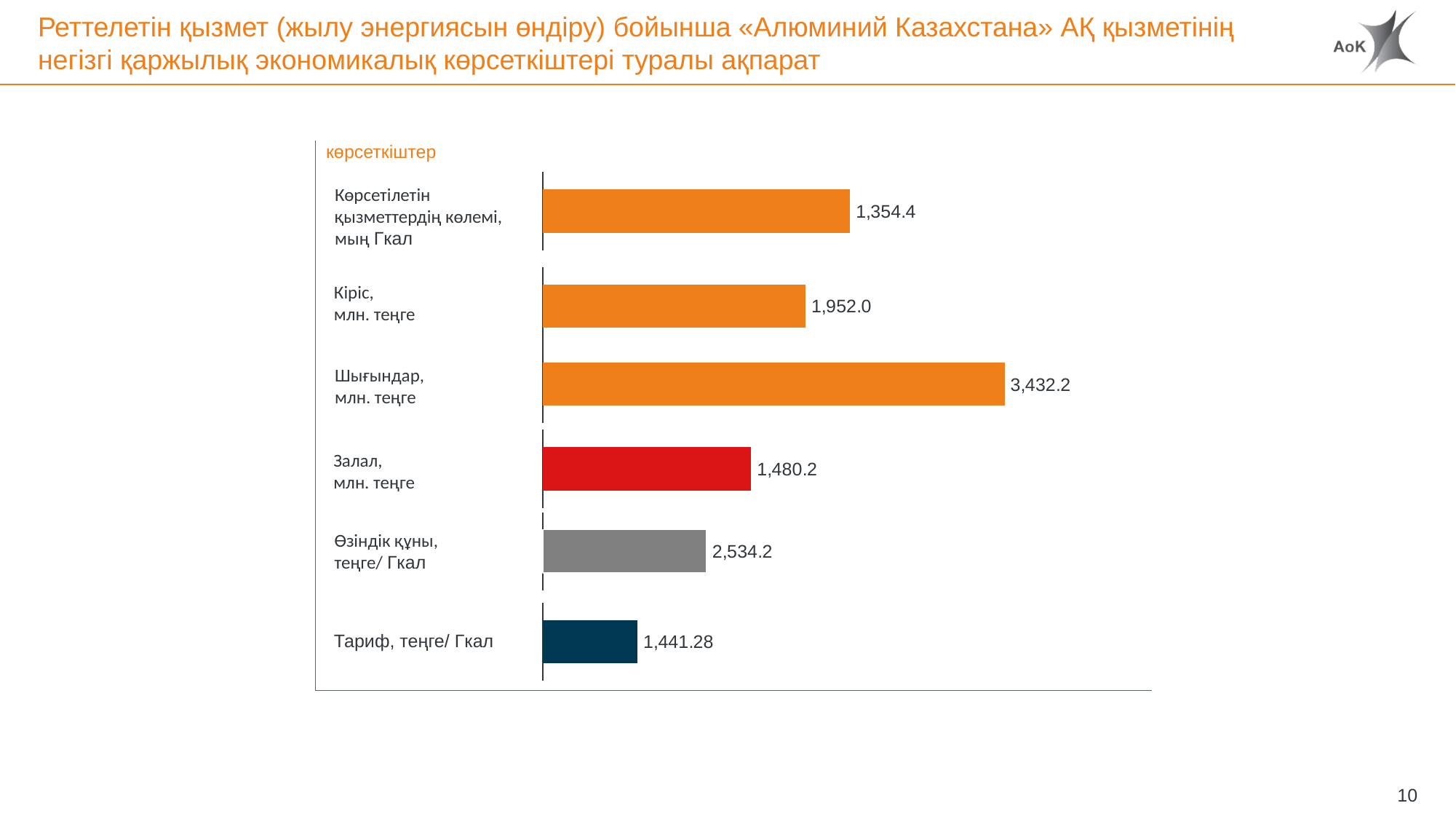
What is the value for Тариф, теңге/ Гкал? 1,441.28 What is the value for Өзіндік құны, теңге/ Гкал? 2,534.2 What colour is the bar for Залал, млн. теңге? Red Which is larger, Кіріс, млн. теңге or Шығындар, млн. теңге? Шығындар, млн. теңге What kind of chart is shown on the slide? Bar chart What is the value for Кіріс, млн. теңге? 1,952.0 Which category has the lowest value? Көрсетілетін қызметтердің көлемі, мың Гкал What is the difference between Шығындар, млн. теңге and Кіріс, млн. теңге? 1,480.2 How many categories are shown in the chart? 6 What is the value for Шығындар, млн. теңге? 3,432.2 What is the difference between Өзіндік құны, теңге/ Гкал and Тариф, теңге/ Гкал? 1,092.92 Which category has the highest value? Шығындар, млн. теңге